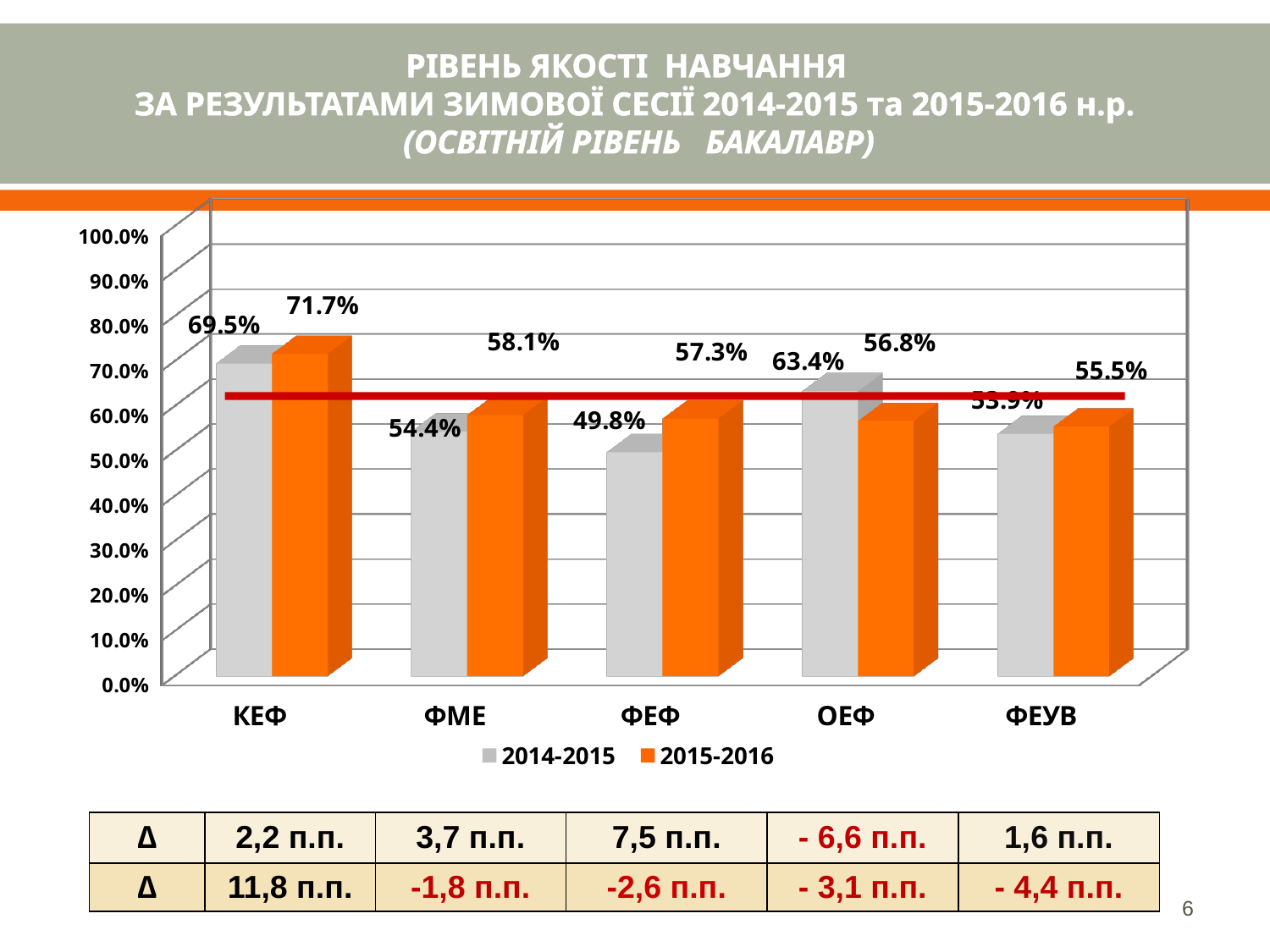
How many series does the legend list? 2 Which category has the highest value in the 2015-2016 series? КЕФ Which category has the lowest value in the 2014-2015 series? ФЕФ How many categories are shown on the x axis? 5 What kind of chart is shown on the slide? bar chart What is the difference between the 2015-2016 and 2014-2015 values for ФЕФ? 7.5% What is the value for ФМЕ in the 2014-2015 series? 54.4% What is the value for КЕФ in the 2015-2016 series? 71.7% Which is larger for ОЕФ: the 2014-2015 value or the 2015-2016 value? 2014-2015 What is the value for ОЕФ in the 2015-2016 series? 56.8% Is the 2015-2016 value for ФЕУВ greater or less than 60.0%? less What is the value for ФЕФ in the 2014-2015 series? 49.8%